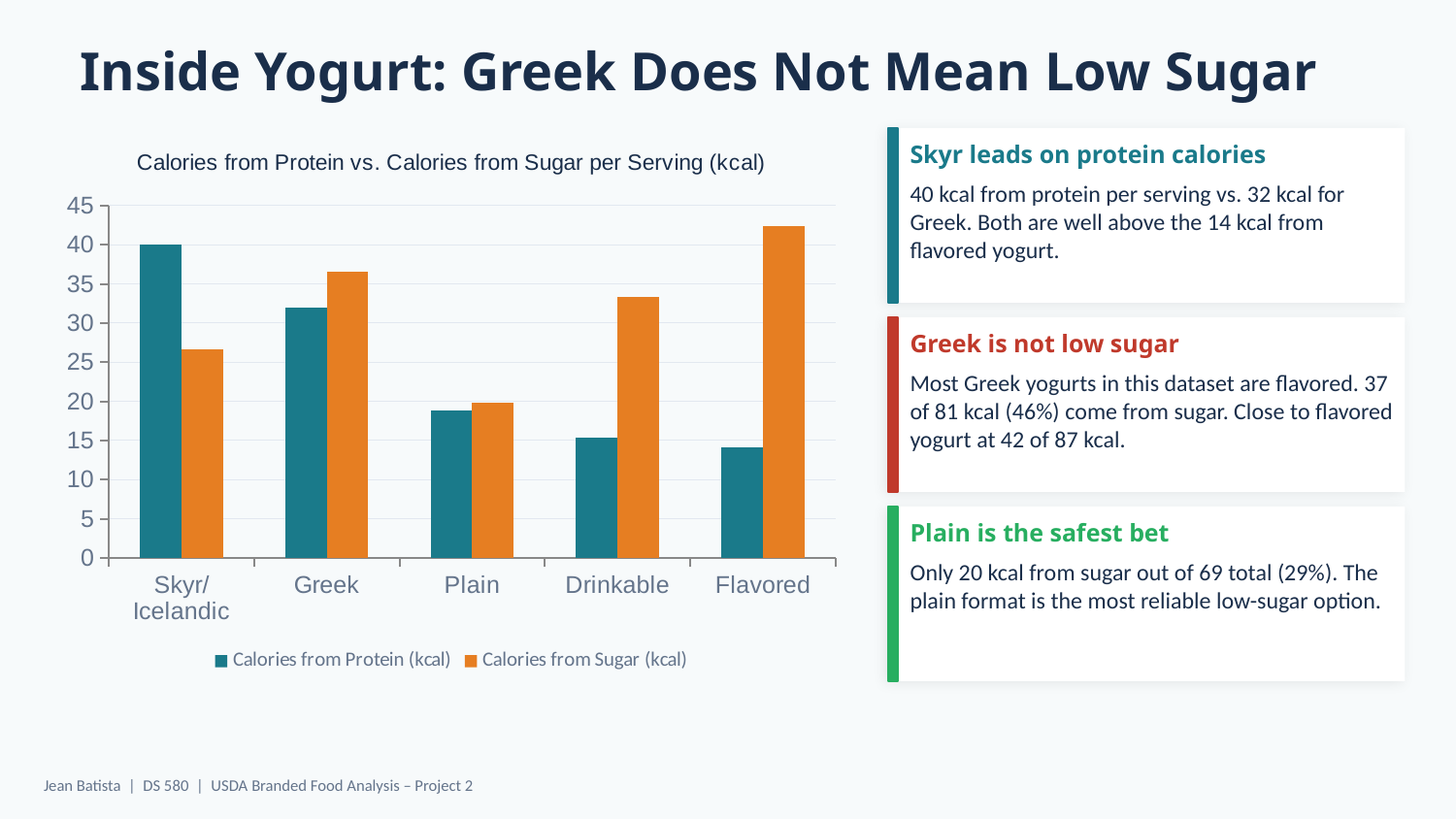
Is the Calories from Sugar value for Flavored greater or less than 40? greater What kind of chart is shown on the slide? bar chart For Skyr/Icelandic, which is larger: Calories from Protein or Calories from Sugar? Calories from Protein Is the Calories from Protein value for Plain greater or less than 20? less Do the Calories from Protein values rise or fall moving from Skyr/Icelandic to Flavored along the x axis? fall Is the Calories from Sugar value for Drinkable greater or less than 30? greater Which category has the highest Calories from Sugar (kcal)? Flavored How many yogurt categories are shown on the x axis? 5 Which category has the highest Calories from Protein (kcal)? Skyr/Icelandic How many series does the legend list? 2 Which category has the lowest Calories from Sugar (kcal)? Plain For Greek, which is larger: Calories from Protein or Calories from Sugar? Calories from Sugar